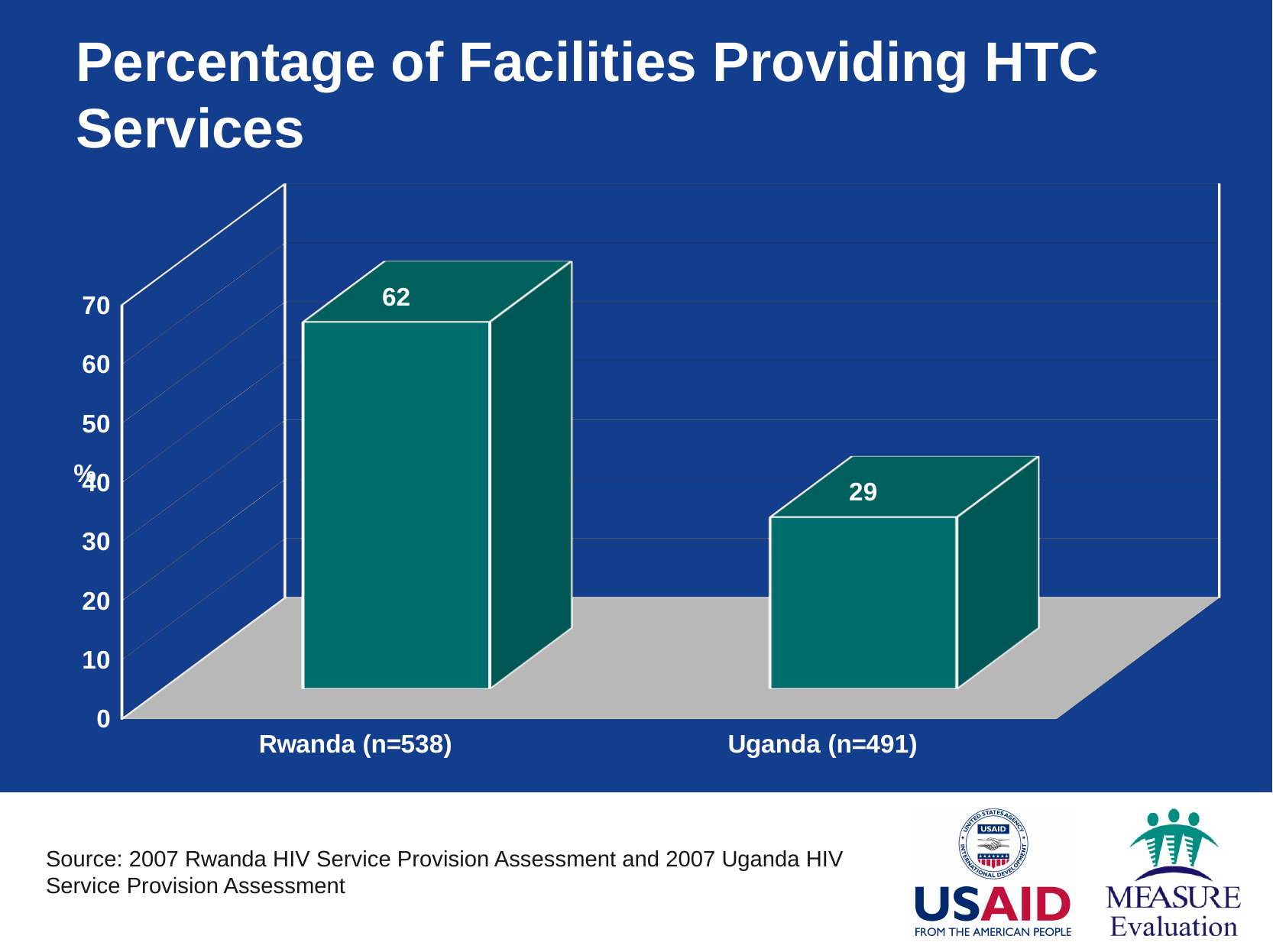
What kind of chart is shown on the slide? bar chart Is the value for Uganda (n=491) greater or less than 40? less Which country has the higher percentage of facilities providing HTC services? Rwanda (n=538) What is the difference in percentage points between Rwanda and Uganda? 33 Which country has the lower percentage of facilities providing HTC services? Uganda (n=491) What percentage of facilities in Rwanda (n=538) provide HTC services? 62 How many countries are shown on the chart? 2 What is the title of the chart? Percentage of Facilities Providing HTC Services Is the value for Rwanda larger or smaller than the value for Uganda? larger What is the sample size (n) for Uganda? 491 What percentage of facilities in Uganda (n=491) provide HTC services? 29 Is the value for Rwanda (n=538) greater or less than 50? greater